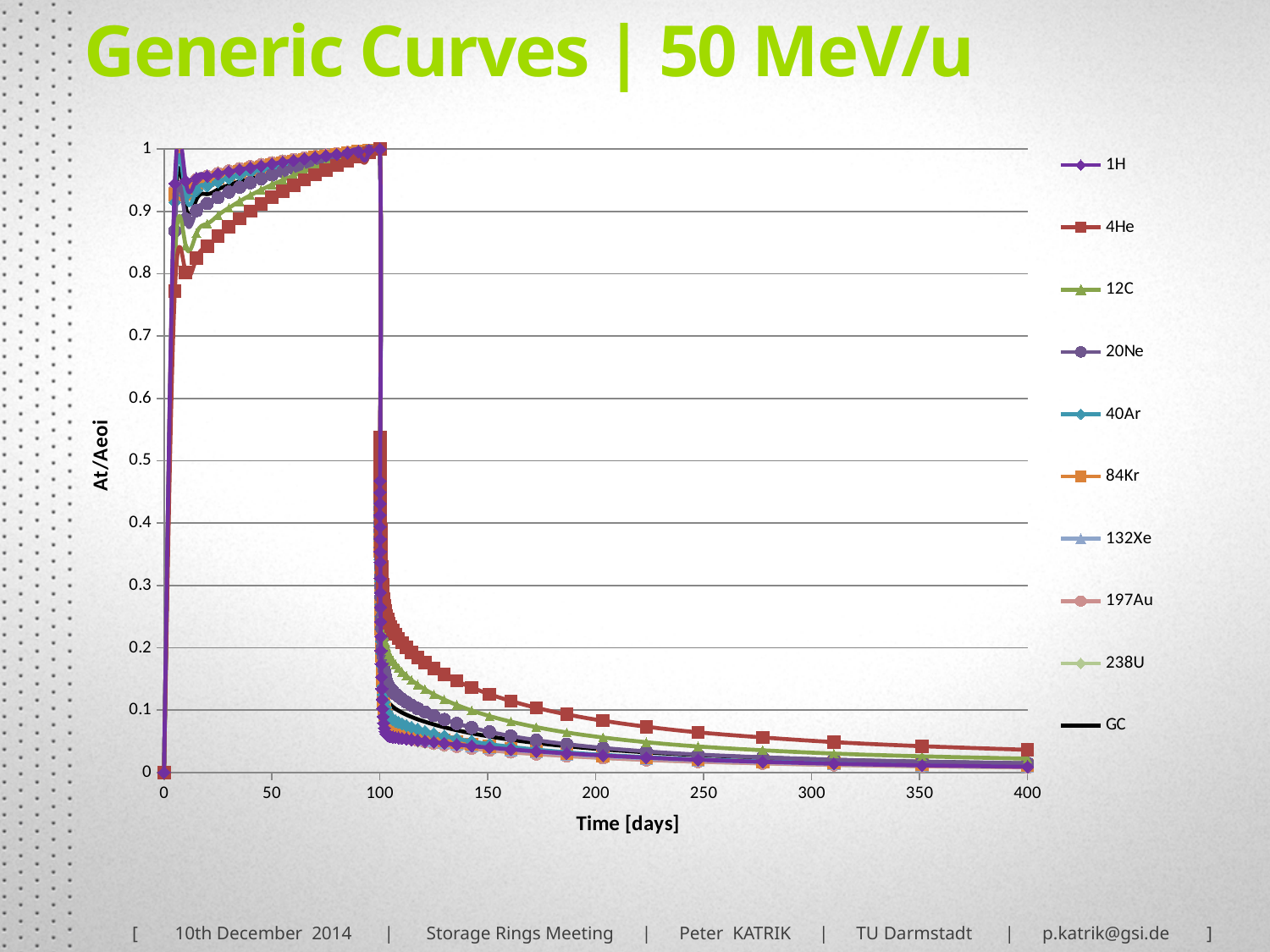
At 200 days, which series has the larger value, 4He or 1H? 4He What is the title of the chart's x axis? Time [days] Is the value for 1H at 300 days greater or less than 0.1? less Is the value for 4He at 400 days greater or less than 0.1? less What is the title of the chart's y axis? At/Aeoi How many series does the legend list? 10 Which series dips to the lowest At/Aeoi value during the first 100 days? 4He Which series has the highest At/Aeoi values in the period after 100 days? 4He Is the value for 12C at 50 days greater or less than 0.9? greater What kind of chart is shown on the slide? line chart Do the At/Aeoi values rise or fall along the x axis between 100 and 400 days? fall